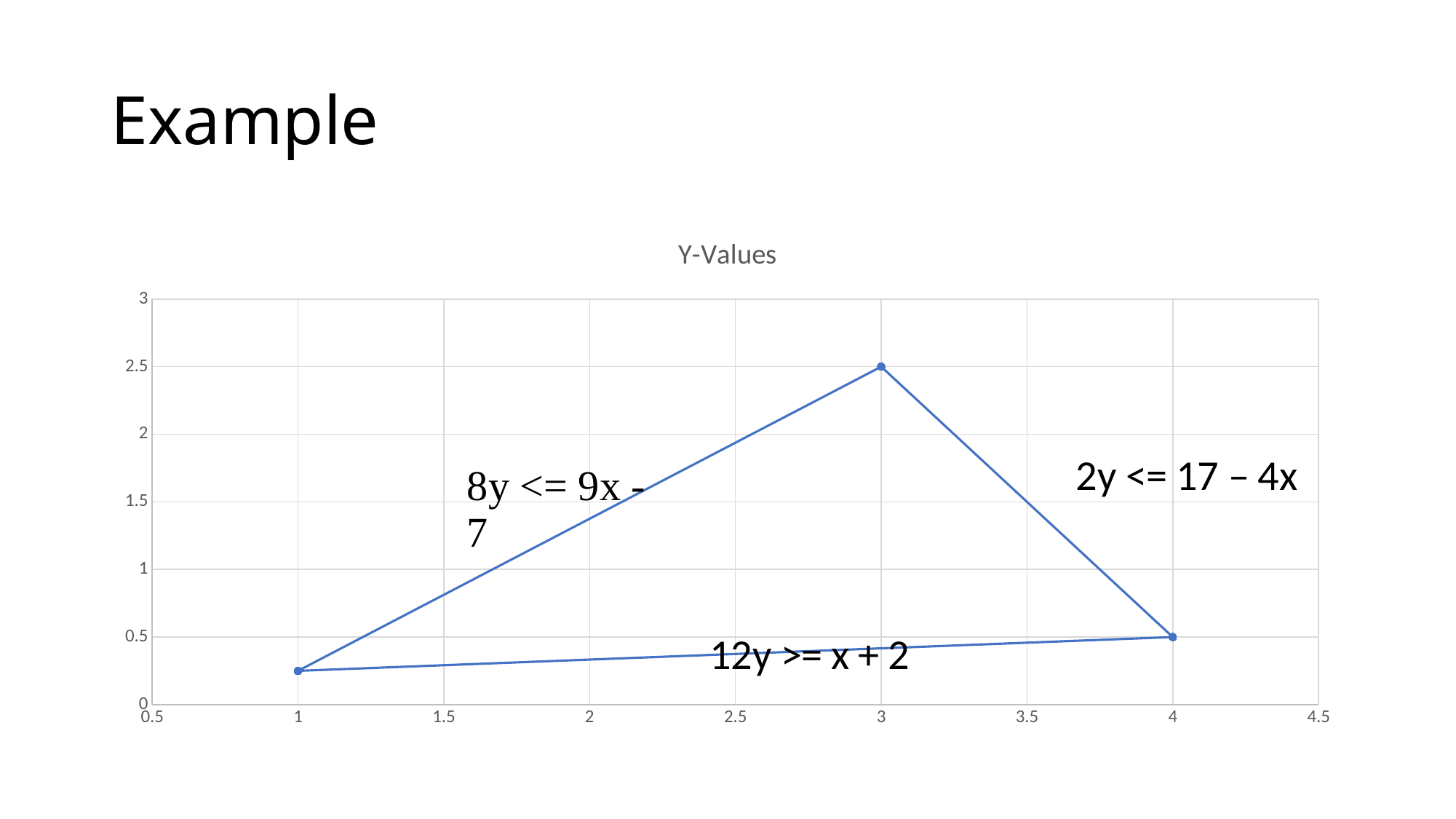
How many vertices does the plotted triangle have? 3 What is the title of the chart? Y-Values Which inequality is written next to the right-hand edge of the triangle? 2y <= 17 – 4x What is the y-value of the plotted point at x = 4? 0.5 Does the y-value rise or fall from x = 3 to x = 4? fall Is the y-value of the plotted point at x = 1 greater or less than 0.5? less Which point has the larger y-value, the one at x = 3 or the one at x = 4? x = 3 What is the difference between the y-value at x = 3 and the y-value at x = 4? 2 What is the highest value shown on the y-axis? 3 At which x-value does the plotted point reach its highest y-value? 3 What is the y-value of the plotted point at x = 3? 2.5 At which x-value does the plotted point have its lowest y-value? 1